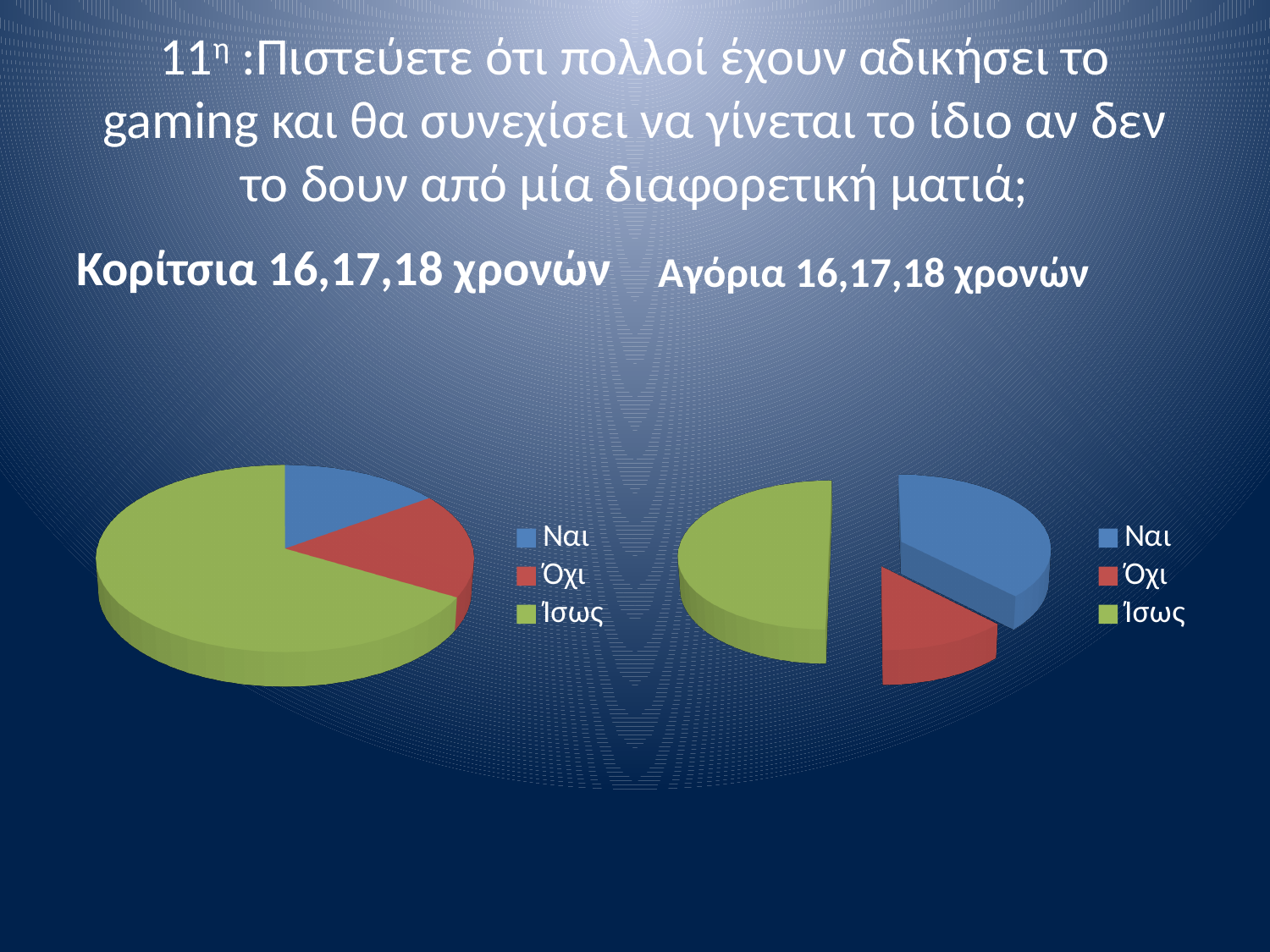
What kind of chart is used for the Κορίτσια 16,17,18 χρονών data? pie chart How many pie charts are shown on the slide? 2 In the Αγόρια 16,17,18 χρονών chart, how many slices does the pie have? 3 In the Αγόρια 16,17,18 χρονών chart, what colour represents Όχι in the legend? red In the Κορίτσια 16,17,18 χρονών chart, which slice is larger, Ίσως or Ναι? Ίσως What kind of chart is used for the Αγόρια 16,17,18 χρονών data? pie chart In the Κορίτσια 16,17,18 χρονών chart, which answer has the largest slice? Ίσως In the Κορίτσια 16,17,18 χρονών chart, how many entries does the legend list? 3 In the Κορίτσια 16,17,18 χρονών chart, what colour represents Ίσως in the legend? green In the Αγόρια 16,17,18 χρονών chart, which answer has the smallest slice? Όχι In the Αγόρια 16,17,18 χρονών chart, which slice is larger, Ναι or Όχι? Ναι In the Αγόρια 16,17,18 χρονών chart, which answer has the largest slice? Ίσως